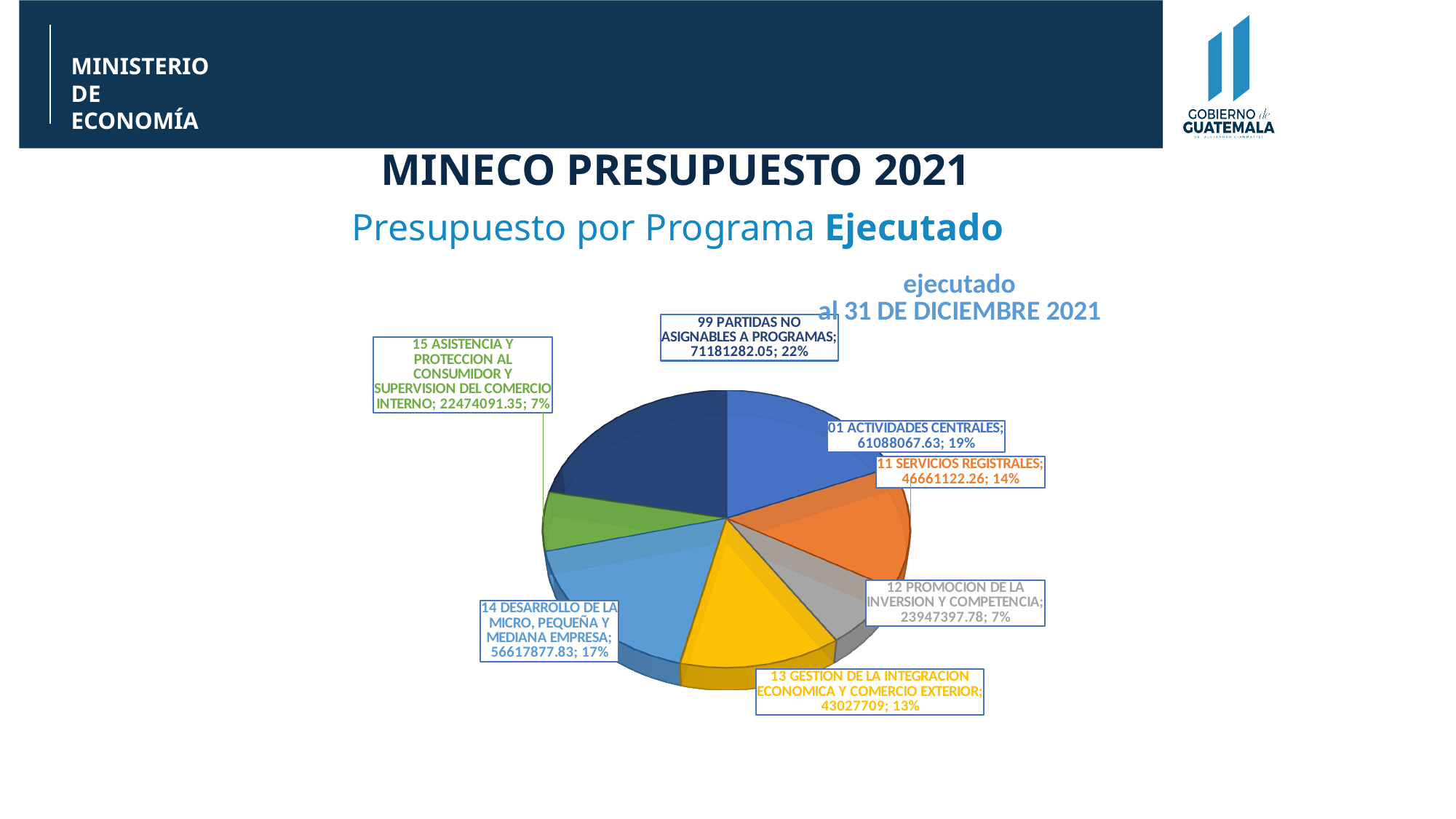
Which program has the largest slice of the pie chart? 99 PARTIDAS NO ASIGNABLES A PROGRAMAS What is the difference between the executed values of 99 PARTIDAS NO ASIGNABLES A PROGRAMAS and 01 ACTIVIDADES CENTRALES? 10093214.42 What percentage share does 12 PROMOCION DE LA INVERSION Y COMPETENCIA have? 7% How many programs (slices) are shown in the pie chart? 7 What is the executed value for 11 SERVICIOS REGISTRALES? 46661122.26 What type of chart is shown on the slide? Pie chart What is the executed value shown for 99 PARTIDAS NO ASIGNABLES A PROGRAMAS? 71181282.05 What is the executed value for 13 GESTION DE LA INTEGRACION ECONOMICA Y COMERCIO EXTERIOR? 43027709 Which program has the smallest executed value in the pie chart? 15 ASISTENCIA Y PROTECCION AL CONSUMIDOR Y SUPERVISION DEL COMERCIO INTERNO What is the title of the pie chart? ejecutado al 31 DE DICIEMBRE 2021 Which is larger, the executed value for 13 GESTION DE LA INTEGRACION ECONOMICA Y COMERCIO EXTERIOR or for 11 SERVICIOS REGISTRALES? 11 SERVICIOS REGISTRALES What percentage share does 14 DESARROLLO DE LA MICRO, PEQUEÑA Y MEDIANA EMPRESA have in the pie chart? 17%